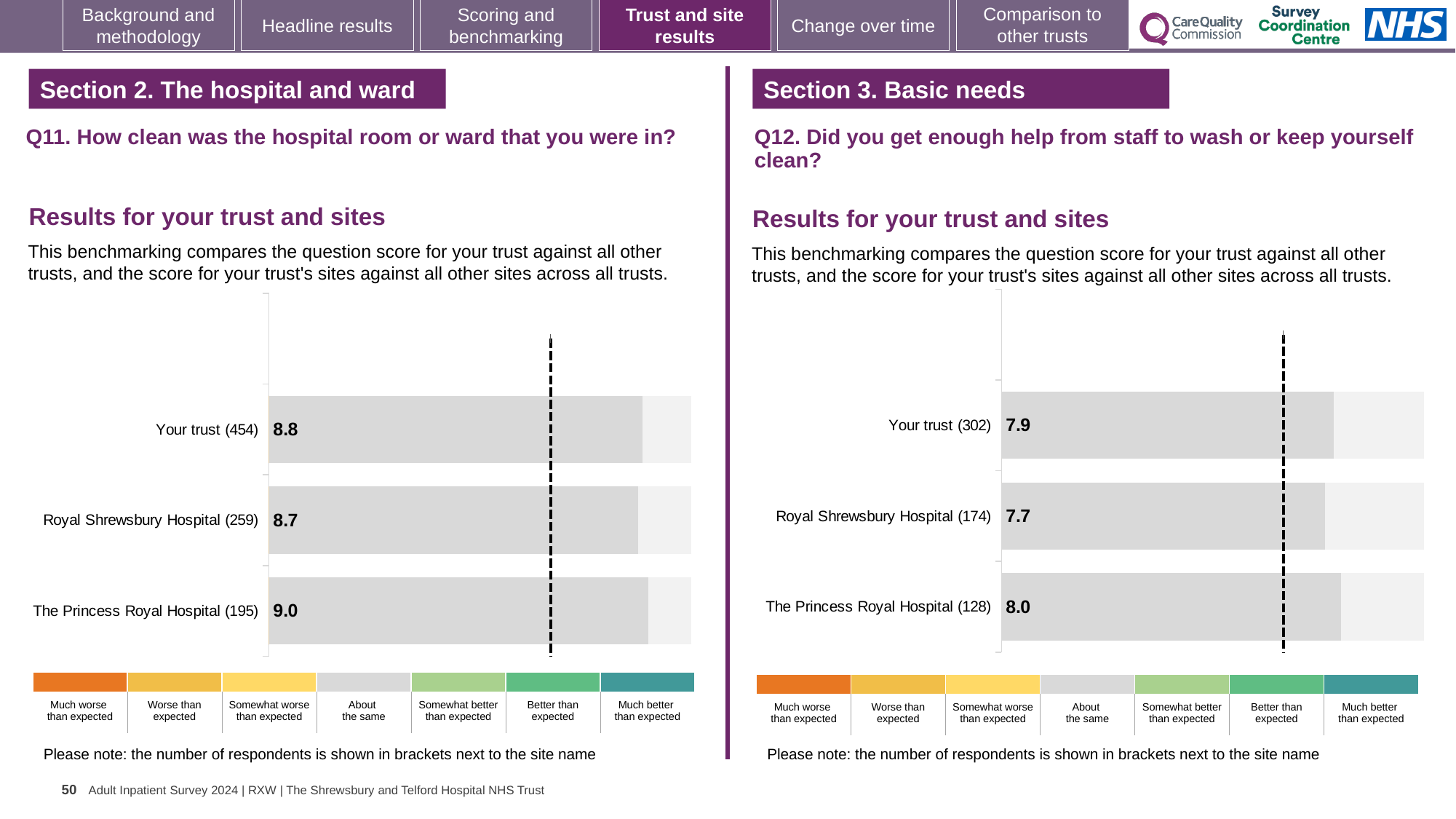
In the Q11 chart, what is the score for The Princess Royal Hospital? 9.0 In the Q11 chart, which site or trust has the highest score? The Princess Royal Hospital What kind of chart is used for the Q12 results? Bar chart In the Q11 chart, which site or trust has the lowest score? Royal Shrewsbury Hospital In the Q12 chart (Did you get enough help from staff to wash or keep yourself clean), what is the score for Royal Shrewsbury Hospital? 7.7 In the Q12 chart, which site or trust has the highest score? The Princess Royal Hospital In the Q12 chart, what is the score for Your trust? 7.9 In the Q11 chart (How clean was the hospital room or ward), what is the score for Your trust? 8.8 In the Q12 chart, what is the difference between the scores for The Princess Royal Hospital and Your trust? 0.1 In the Q11 chart, what is the difference between the scores for The Princess Royal Hospital and Royal Shrewsbury Hospital? 0.3 How many bars are plotted in the Q11 chart? 3 In the Q12 chart, which is larger: the score for Your trust or the score for Royal Shrewsbury Hospital? Your trust